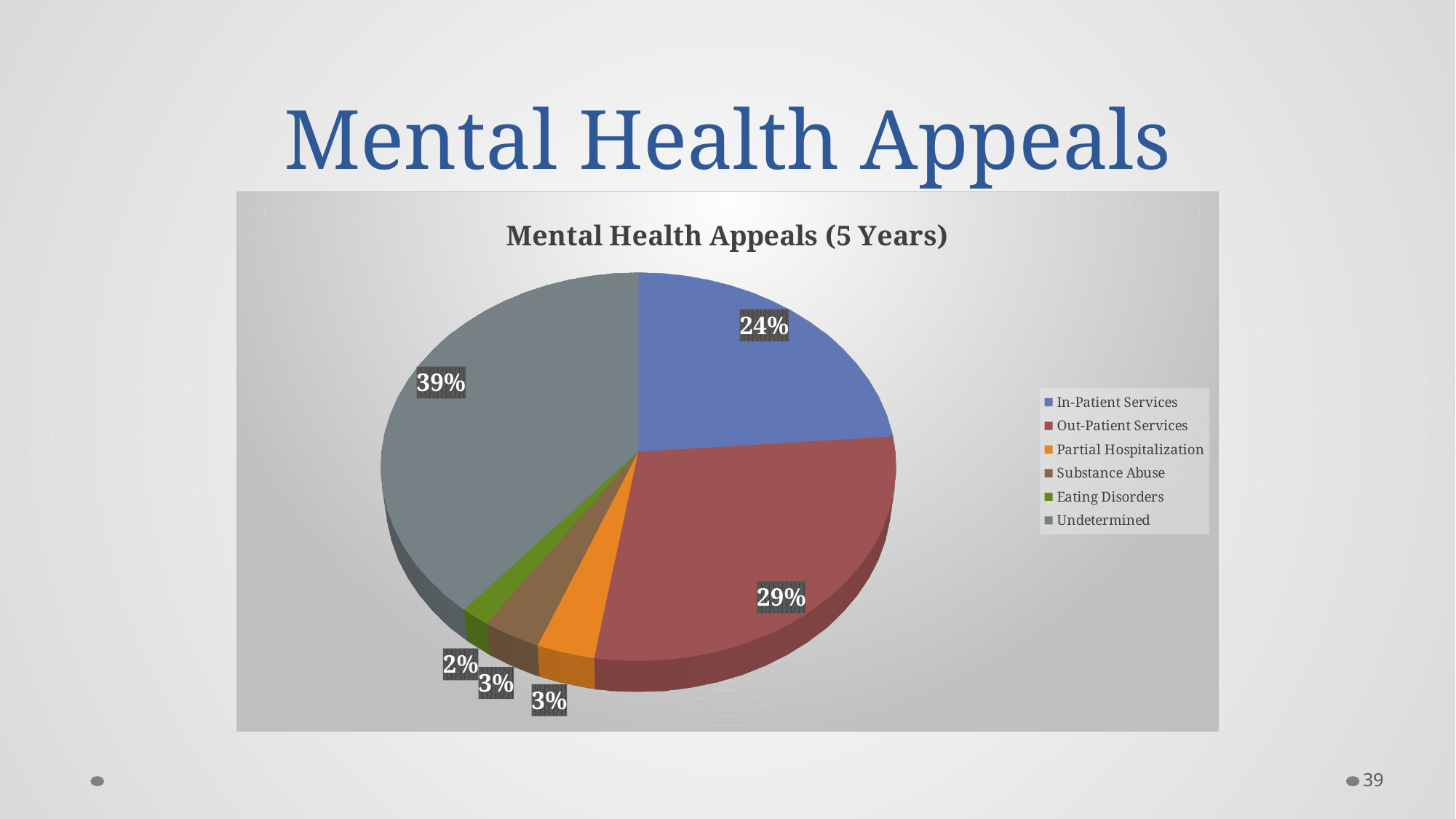
Which category has the largest share of mental health appeals? Undetermined What share of mental health appeals is for Out-Patient Services? 29% How many categories does the legend list? 6 What type of chart is shown on the slide? Pie chart What colour represents Partial Hospitalization in the chart? Orange What is the difference in percentage points between the Undetermined share and the In-Patient Services share? 15 percentage points What share of mental health appeals is Undetermined? 39% Which has a larger share, In-Patient Services or Out-Patient Services? Out-Patient Services What share of mental health appeals is for In-Patient Services? 24% What is the title of the chart? Mental Health Appeals (5 Years) Which category has the smallest share of mental health appeals? Eating Disorders